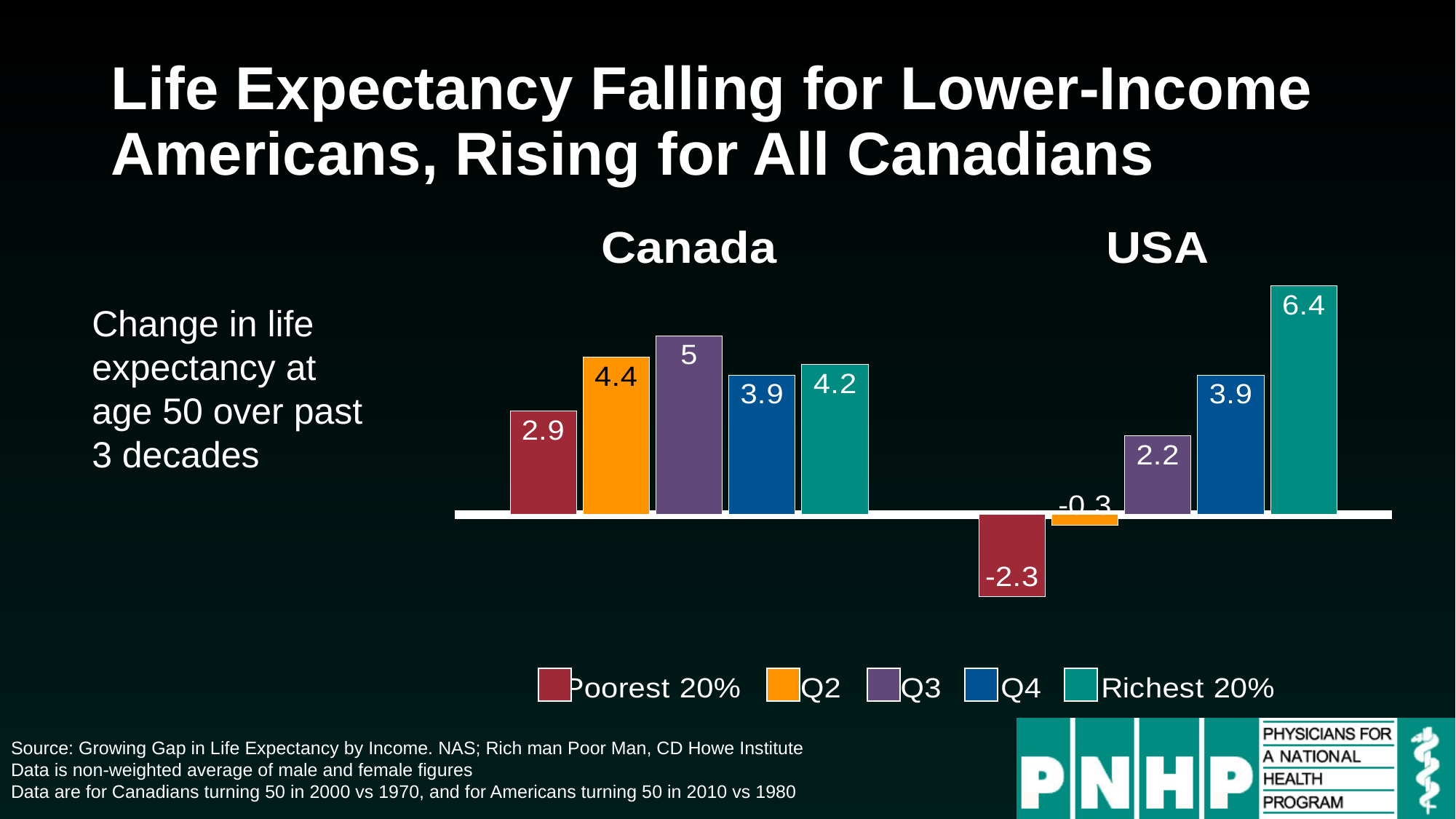
What is the change in life expectancy for the Poorest 20% in Canada? 2.9 Which income group has the lowest value in the USA? Poorest 20% What is the value for Q2 in the USA? -0.3 Do the USA values rise or fall from the Poorest 20% to the Richest 20%? Rise What is the value for Q3 in Canada? 5 Which income group has the highest value in the USA? Richest 20% Which income group has the highest value in Canada? Q3 What kind of chart is shown on the slide? Bar chart What is the difference between the Richest 20% and the Poorest 20% values in the USA? 8.7 How many series does the legend list? 5 What is the change in life expectancy for the Richest 20% in the USA? 6.4 Which is larger: the Poorest 20% value for Canada or for the USA? Canada